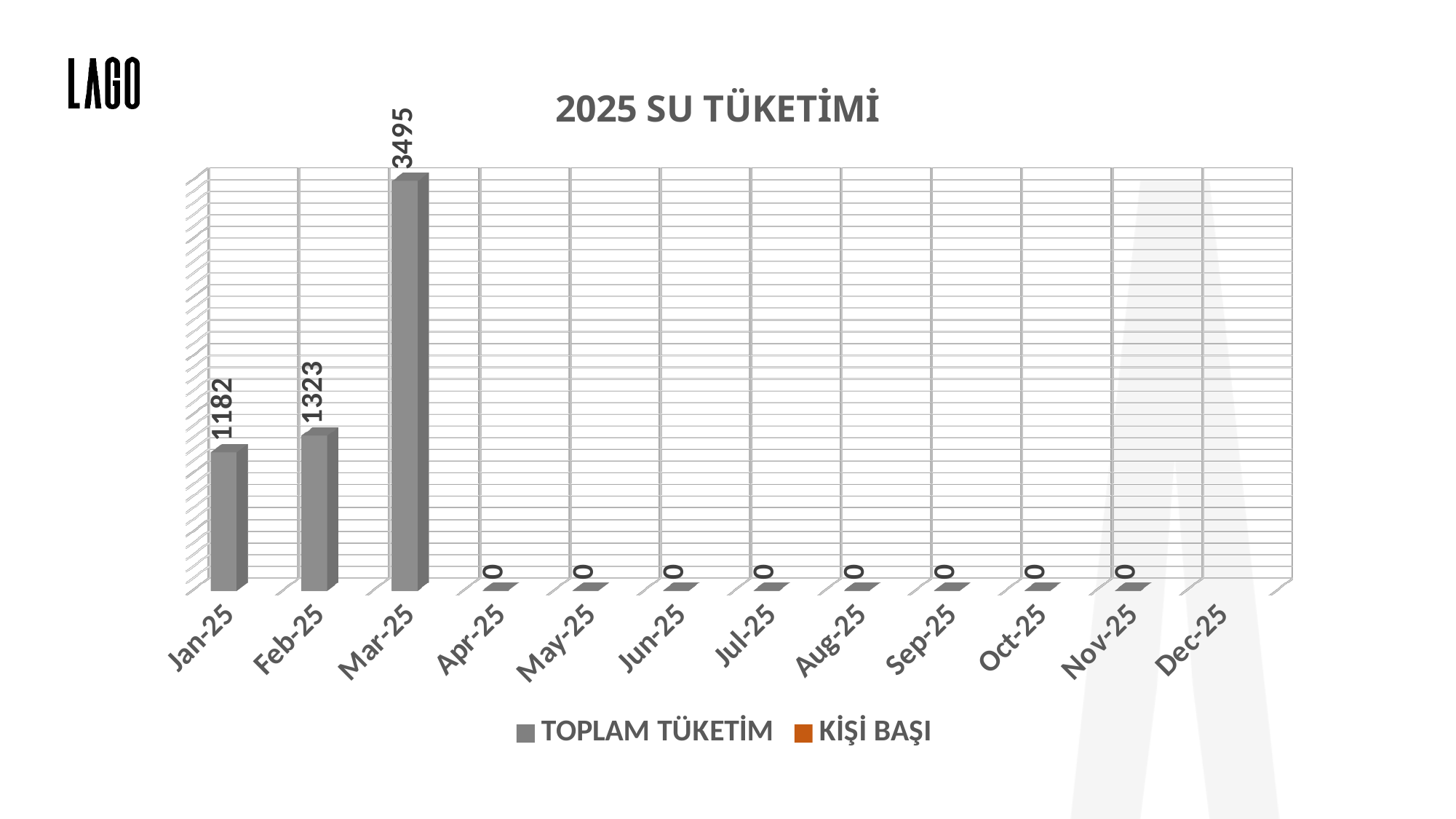
What is the title of the chart? 2025 SU TÜKETİMİ What is the TOPLAM TÜKETİM value for Feb-25? 1323 What is the TOPLAM TÜKETİM value for Jan-25? 1182 What kind of chart is shown on the slide? Bar chart Which is larger, the value for Jan-25 or the value for Feb-25? Feb-25 How many series does the legend list? 2 What is the TOPLAM TÜKETİM value for Mar-25? 3495 Which month has the highest TOPLAM TÜKETİM value? Mar-25 What is the difference between the Mar-25 and Feb-25 TOPLAM TÜKETİM values? 2172 How many month categories are shown on the x axis? 12 What value is labelled for Jun-25? 0 What is the difference between the Feb-25 and Jan-25 TOPLAM TÜKETİM values? 141